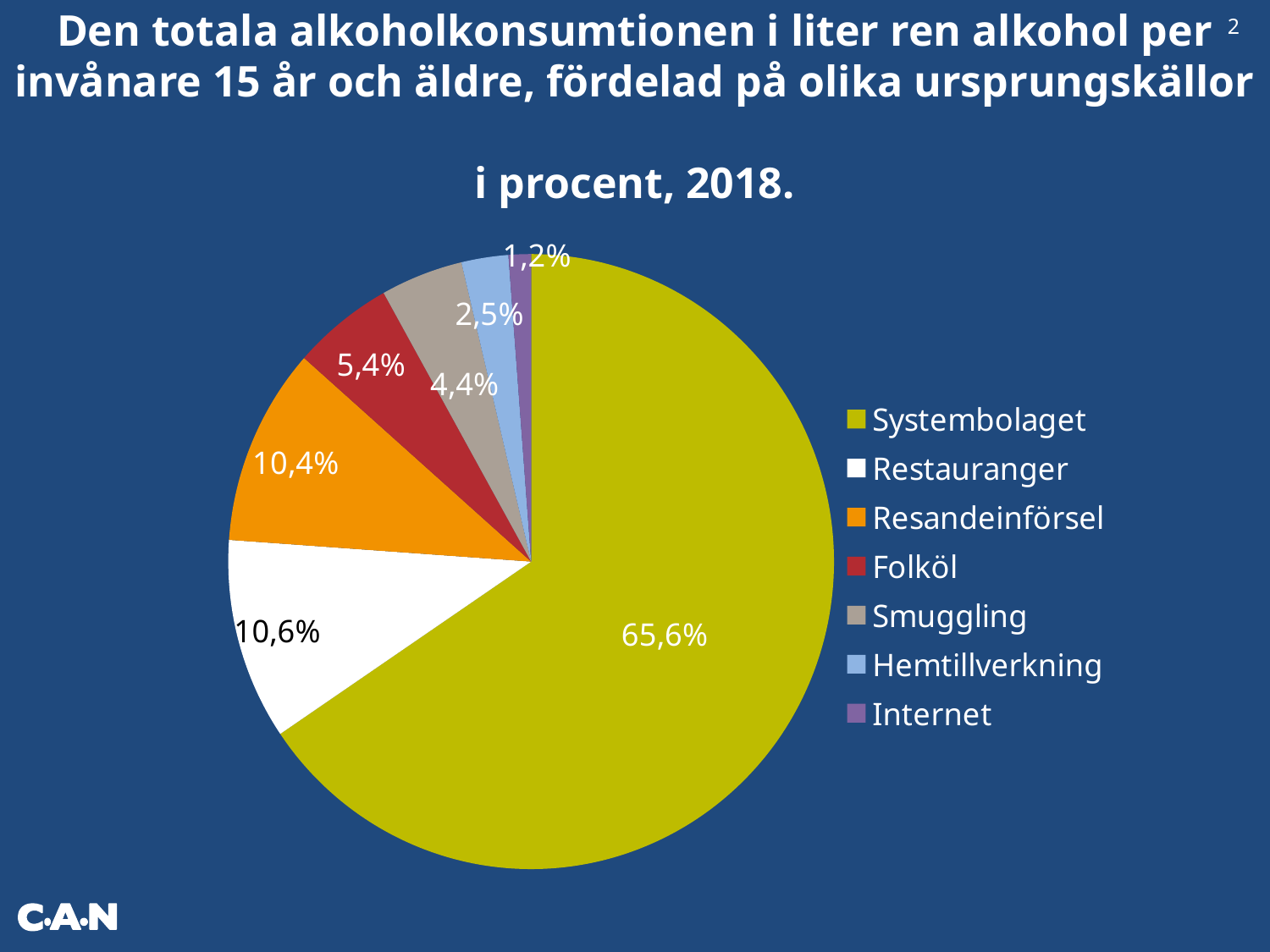
What colour is the slice for Resandeinförsel? orange What is the value shown for Hemtillverkning? 2,5% What is the value shown for Resandeinförsel? 10,4% How many categories does the legend list? 7 What is the difference in percentage points between Folköl and Smuggling? 1,0 What is the difference in percentage points between Systembolaget and Restauranger? 55,0 Which category has the largest slice of the pie? Systembolaget Which category has the smallest slice of the pie? Internet What share of the pie does Systembolaget account for? 65,6% Which is larger, the slice for Folköl or the slice for Smuggling? Folköl What kind of chart is shown on the slide? pie chart What is the value shown for Folköl? 5,4%